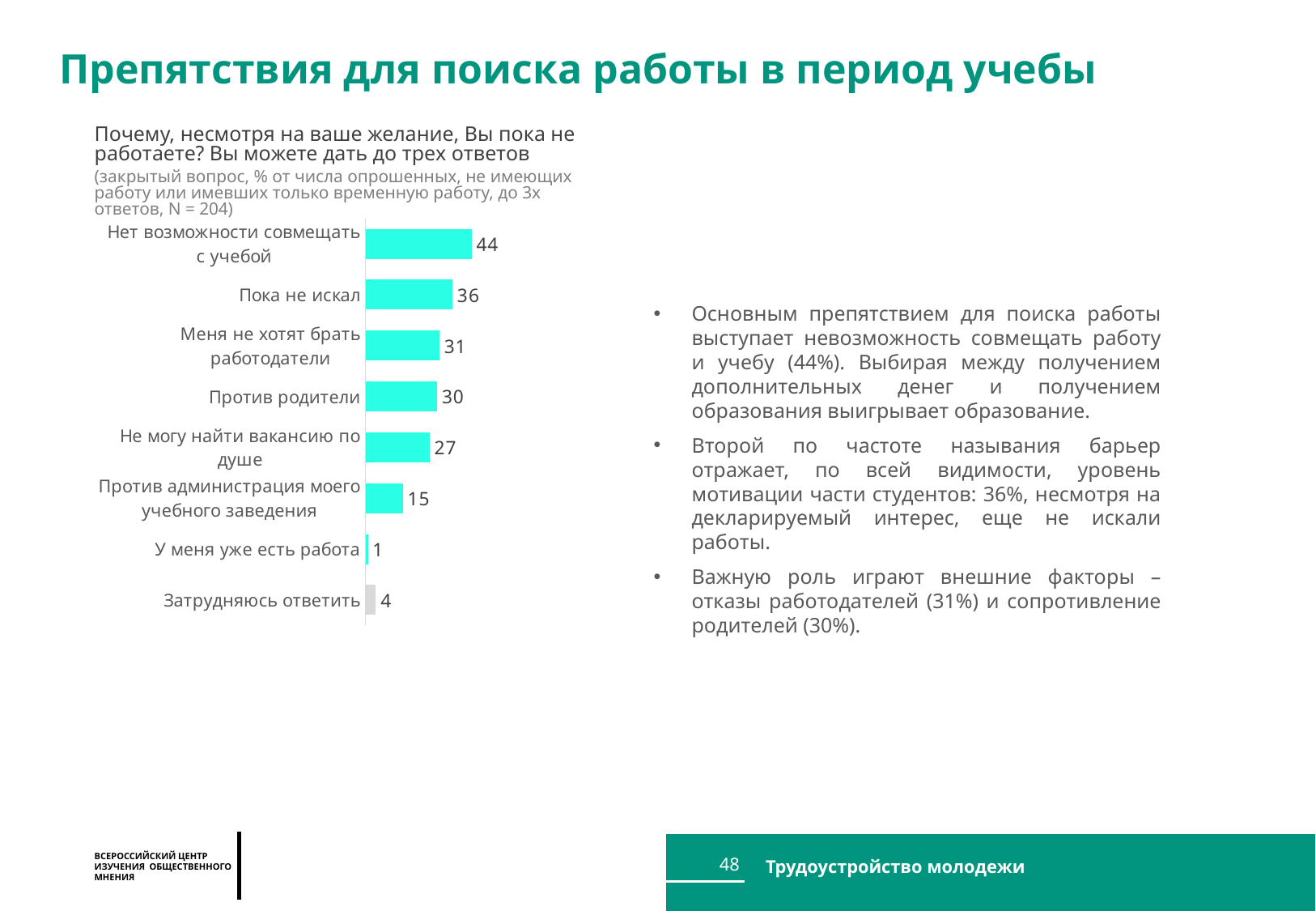
What is the value for "Нет возможности совмещать с учебой"? 44 What is the value for "Пока не искал"? 36 Which category has the lowest value? У меня уже есть работа What is the value for "Затрудняюсь ответить"? 4 What kind of chart is shown on the slide? Bar chart Which bar is shown in grey rather than turquoise? Затрудняюсь ответить How many categories are shown in the chart? 8 Which is larger: the value for "Меня не хотят брать работодатели" or the value for "Не могу найти вакансию по душе"? Меня не хотят брать работодатели Which category has the highest value? Нет возможности совмещать с учебой What is the value for "Против администрация моего учебного заведения"? 15 What is the value for "Против родители"? 30 What is the difference between the values for "Нет возможности совмещать с учебой" and "Пока не искал"? 8